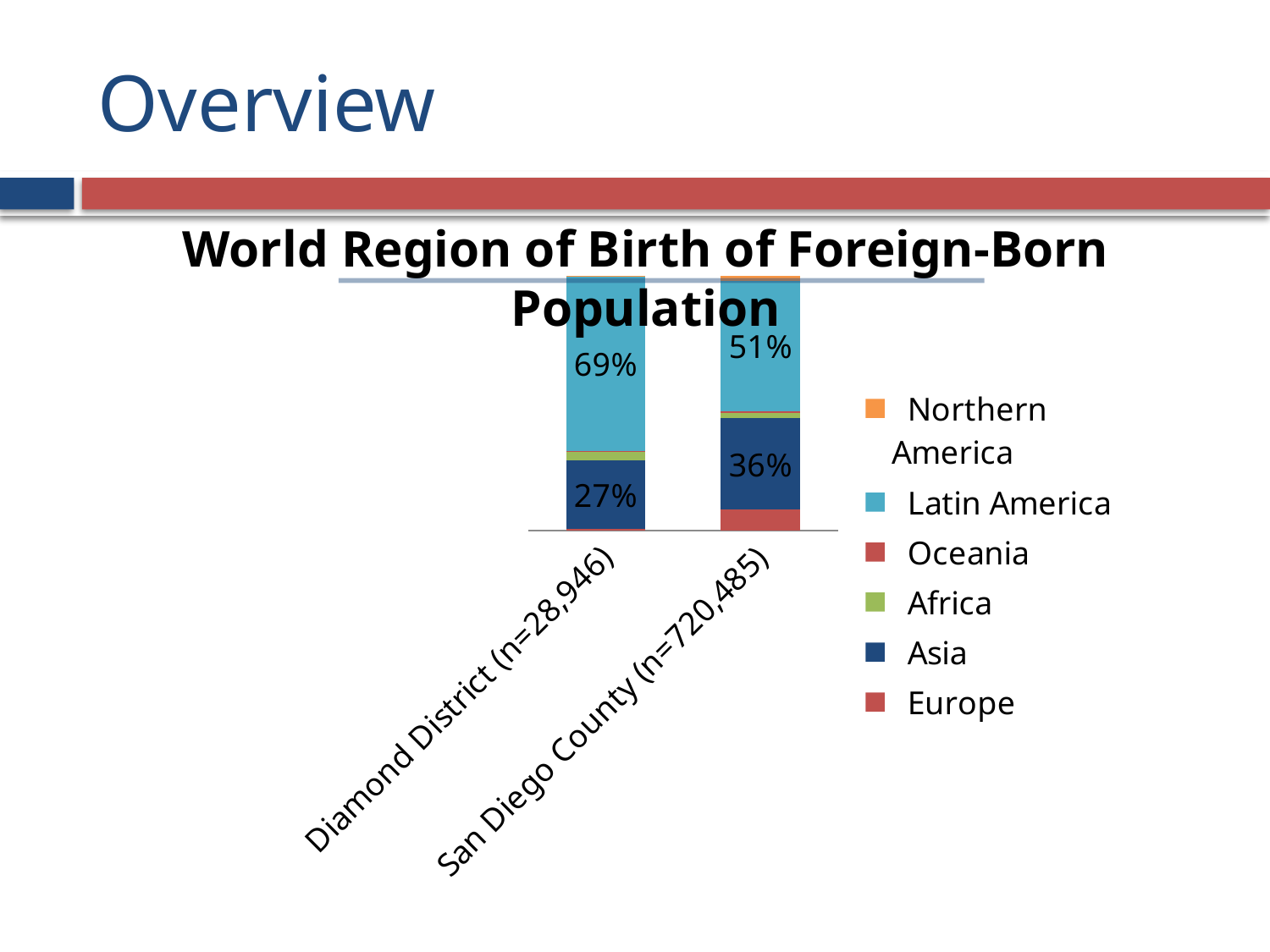
Which category has the higher Asia share, Diamond District or San Diego County? San Diego County Which category has the higher Latin America share, Diamond District or San Diego County? Diamond District What is the title of the chart? World Region of Birth of Foreign-Born Population How many categories are shown on the x axis of the chart? 2 What is the Latin America share for San Diego County (n=720,485)? 51% What is the Asia share for San Diego County (n=720,485)? 36% What is the Latin America share for Diamond District (n=28,946)? 69% What is the difference in percentage points between the Latin America shares of Diamond District and San Diego County? 18 percentage points How many series does the legend list? 6 What kind of chart is shown on the slide? Stacked bar chart What is the difference in percentage points between the Asia shares of San Diego County and Diamond District? 9 percentage points What is the Asia share for Diamond District (n=28,946)? 27%